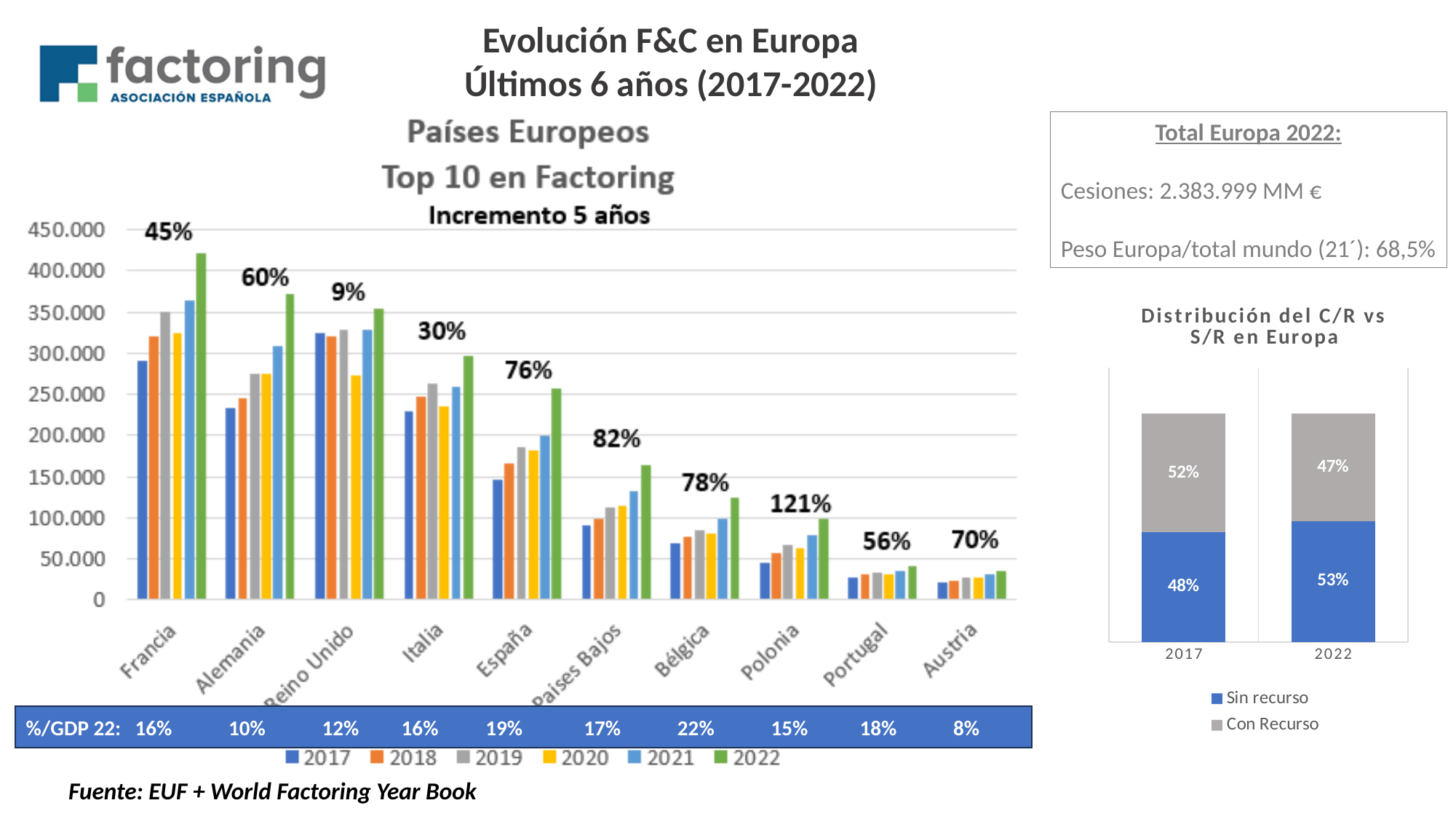
In the 'Países Europeos Top 10 en Factoring' chart, is the 2022 value for Francia greater or less than 400.000? greater In the 'Países Europeos Top 10 en Factoring' chart, how many series does the legend list? 6 In the 'Países Europeos Top 10 en Factoring' chart, which country has the highest 'Incremento 5 años' percentage? Polonia In the 'Países Europeos Top 10 en Factoring' chart, what is the 'Incremento 5 años' percentage shown for Reino Unido? 9% In the 'Países Europeos Top 10 en Factoring' chart, which country has the lowest 'Incremento 5 años' percentage? Reino Unido In the 'Países Europeos Top 10 en Factoring' chart, what is the 'Incremento 5 años' percentage shown for Polonia? 121% In the 'Países Europeos Top 10 en Factoring' chart, what is the difference between the 'Incremento 5 años' percentages of Países Bajos and Bélgica? 4% In the 'Países Europeos Top 10 en Factoring' chart, is the 2022 value for Austria greater or less than 50.000? less In the 'Distribución del C/R vs S/R en Europa' chart, what is the 'Sin recurso' share in 2022? 53% In the 'Países Europeos Top 10 en Factoring' chart, how many countries are shown on the x axis? 10 What kind of chart is 'Distribución del C/R vs S/R en Europa'? Stacked bar chart In the 'Distribución del C/R vs S/R en Europa' chart, which is larger in 2017: 'Sin recurso' or 'Con Recurso'? Con Recurso